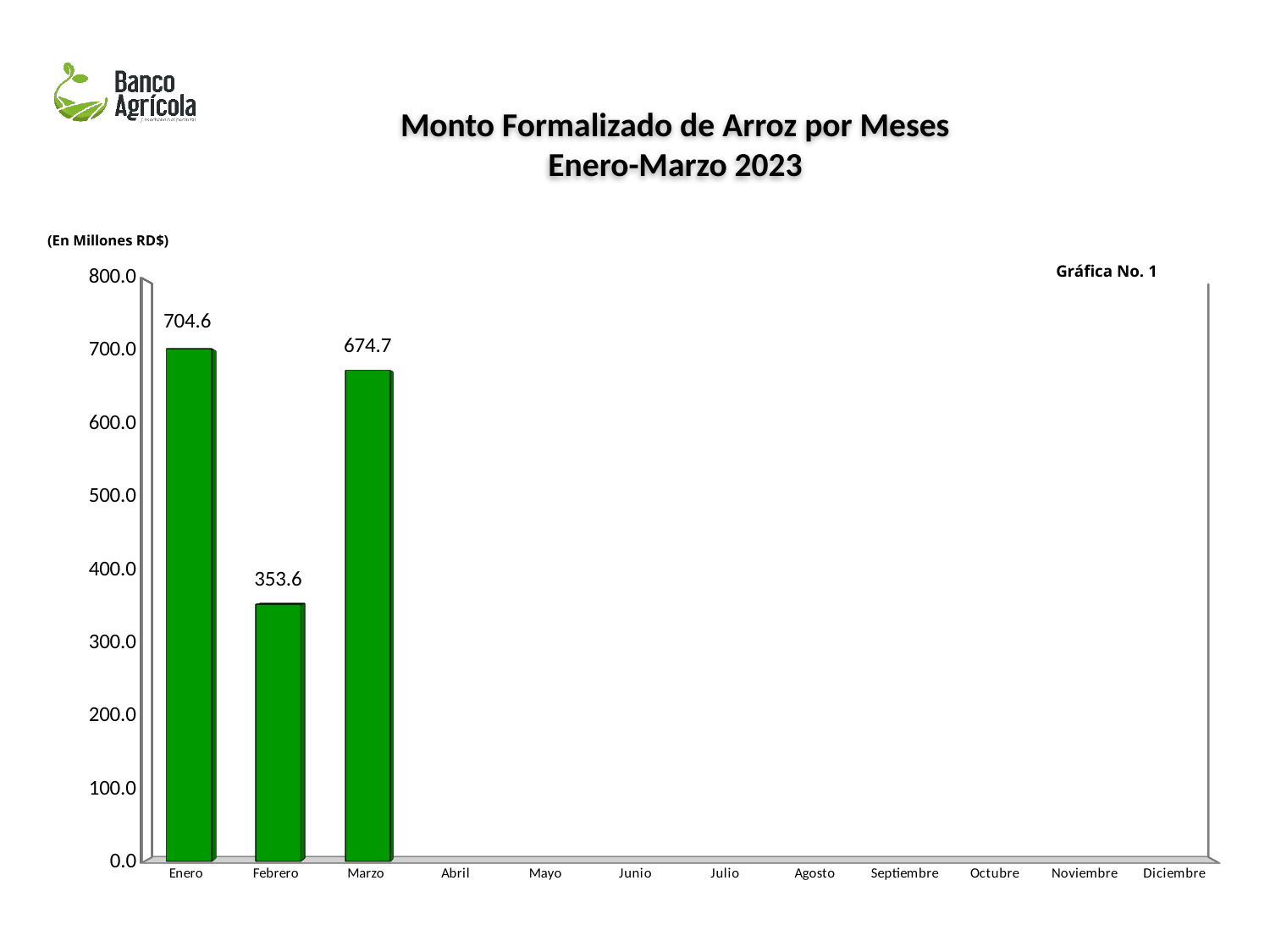
Which is larger, the value for Febrero or the value for Marzo? Marzo How many months have a bar plotted on the chart? 3 What kind of chart is shown? bar chart Which month has the highest value? Enero What is the value for Febrero? 353.6 What is the value for Enero? 704.6 Is the value for Febrero greater or less than 400.0? less What is the difference between the values for Enero and Marzo? 29.9 What is the difference between the values for Enero and Febrero? 351.0 What unit is stated for the values on the chart? En Millones RD$ What is the value for Marzo? 674.7 Which month with a plotted bar has the lowest value? Febrero